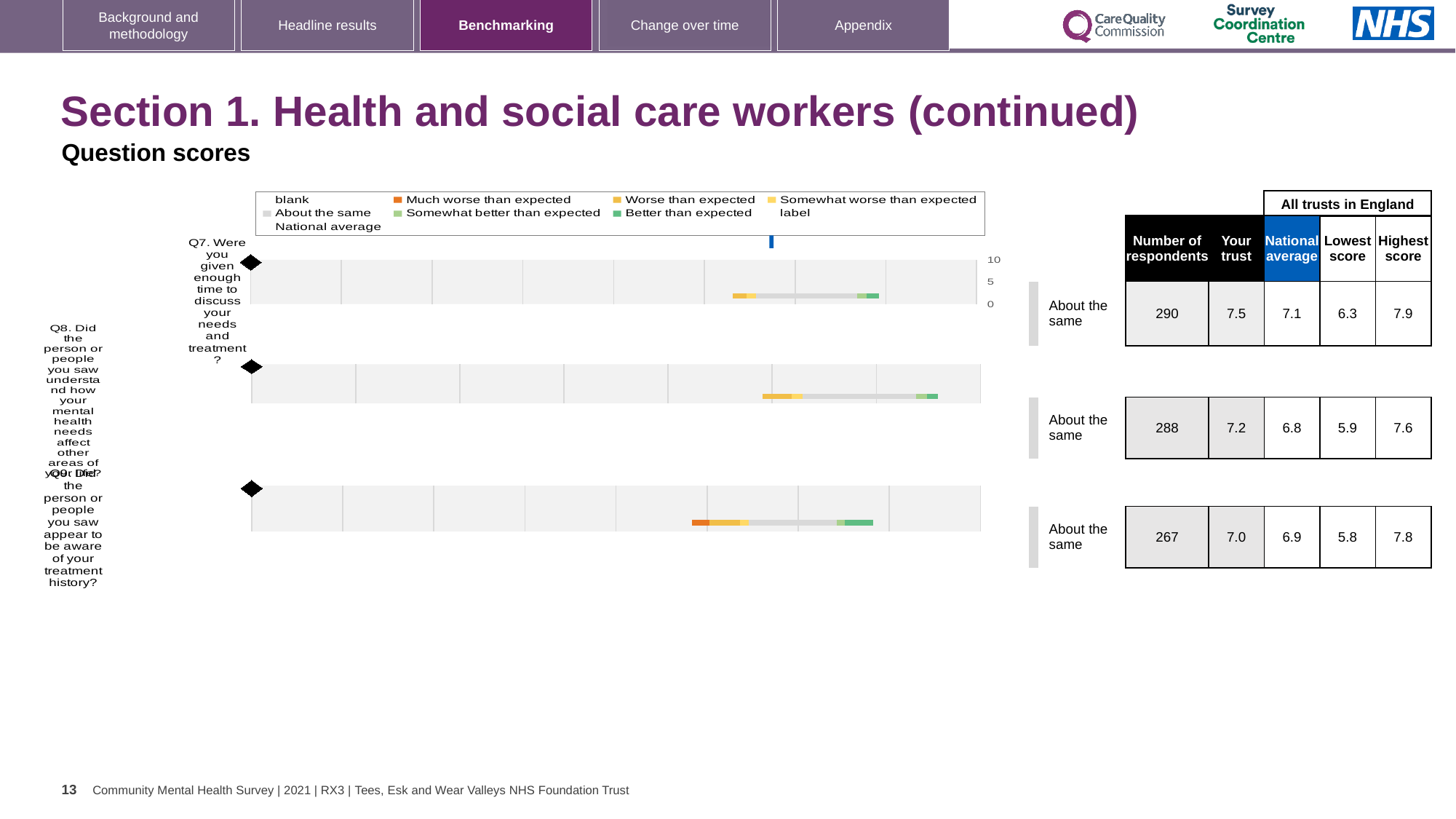
Which question has the highest 'Your trust' score? Q7 Which question has the lowest 'Lowest score' among all trusts in England? Q9 How many questions are plotted on the slide? 3 What kind of chart is used to show the question scores? Bar chart How many respondents answered Q9 (Did the person or people you saw appear to be aware of your treatment history?)? 267 What is the maximum value shown on the score axis of the charts? 10 What benchmark category is shown for Q9? About the same What is the highest score among all trusts in England for Q7? 7.9 What is the national average score for Q8 (Did the person or people you saw understand how your mental health needs affect other areas of your life?)? 6.8 What is the difference between the 'Your trust' score and the national average for Q7? 0.4 What is the 'Your trust' score for Q7 (Were you given enough time to discuss your needs and treatment?)? 7.5 For Q8, which is larger: the 'Your trust' score or the national average? Your trust